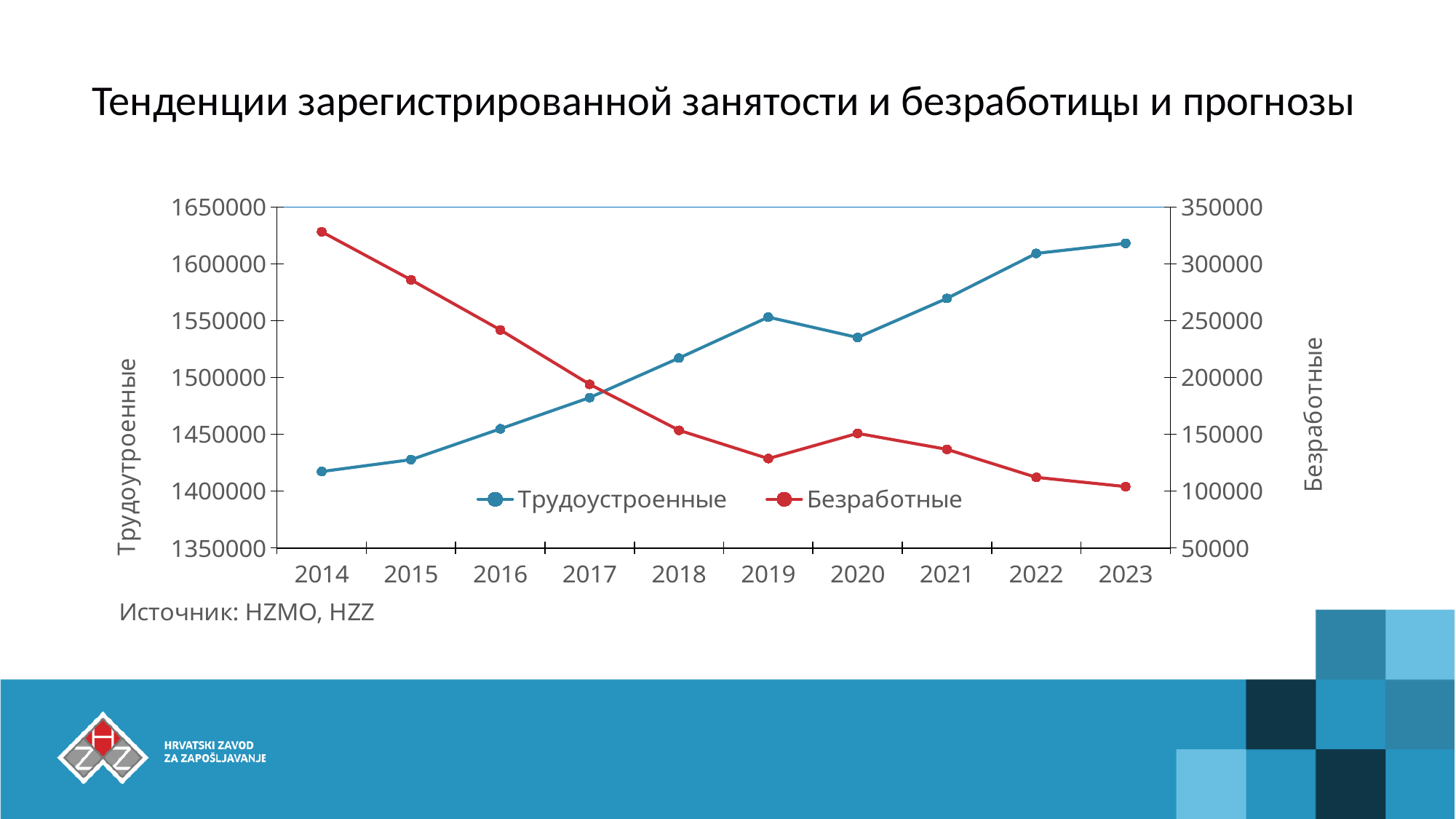
What kind of chart is shown on the slide? line chart Is the Безработные value for 2014 greater or less than 300000? greater How many series does the legend list? 2 In which year is the Безработные series lowest? 2023 In which year is the Трудоустроенные series lowest? 2014 Is the Трудоустроенные value for 2023 greater or less than 1600000? greater What is the title of the chart's right-hand vertical axis? Безработные In which year is the Трудоустроенные series highest? 2023 In which year is the Безработные series highest? 2014 Does the Безработные series generally rise or fall from 2014 to 2023? fall Which year has the larger Трудоустроенные value, 2019 or 2020? 2019 How many years are shown on the x axis? 10